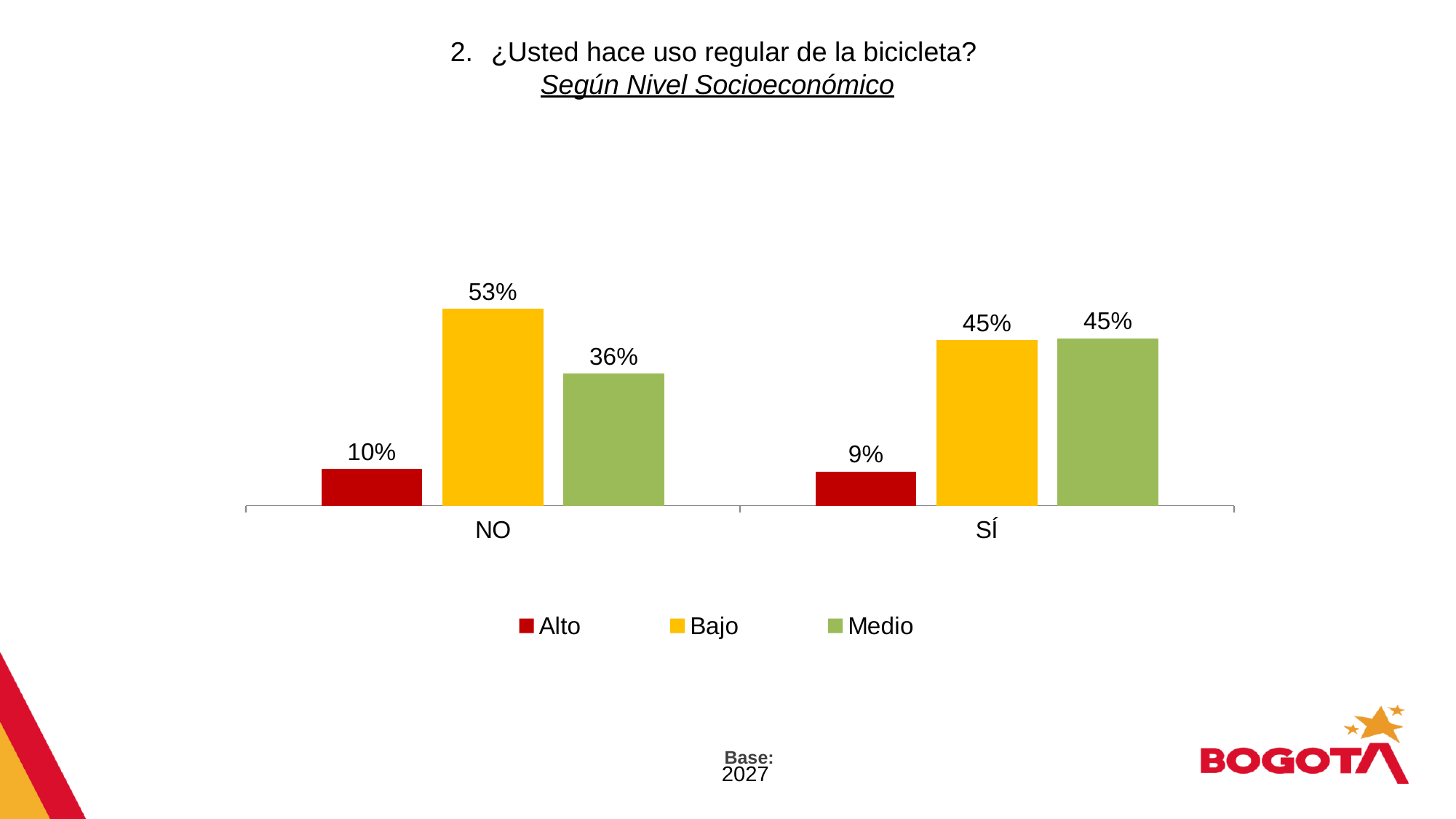
Which series has the highest value in the NO category? Bajo What is the difference between the Alto values for NO and SÍ? 1% What is the difference between the Bajo and Medio values in the NO category? 17% How many series does the legend list? 3 What is the value for Bajo in the NO category? 53% How many categories are shown on the x axis? 2 What is the value for Alto in the SÍ category? 9% Which is larger: the Bajo value for NO or the Bajo value for SÍ? NO What is the value for Medio in the NO category? 36% What is the value for Medio in the SÍ category? 45% What kind of chart is shown on the slide? Bar chart Which series has the lowest value in the SÍ category? Alto